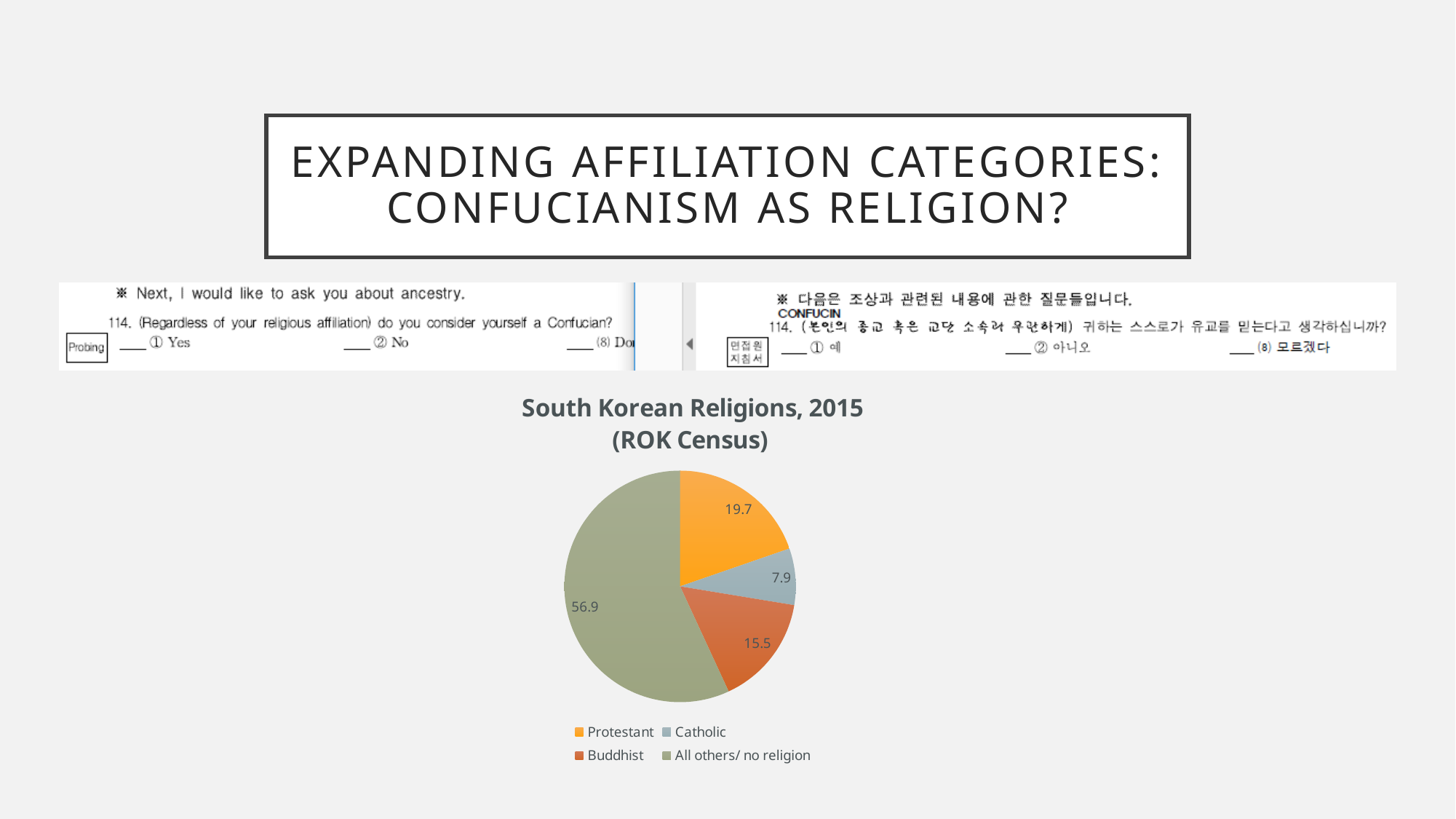
What is the value for Protestant? 19.7 How many categories does the pie chart show? 4 What is the title of the chart? South Korean Religions, 2015 (ROK Census) Which is larger, the Protestant slice or the Catholic slice? Protestant Which category has the smallest slice? Catholic What type of chart is shown on the slide? pie chart What is the value for Buddhist? 15.5 Which category has the largest slice? All others/ no religion What is the value for Catholic? 7.9 What is the difference between the Protestant and Buddhist values? 4.2 What colour is the Buddhist slice? orange-red What is the value for All others/ no religion? 56.9